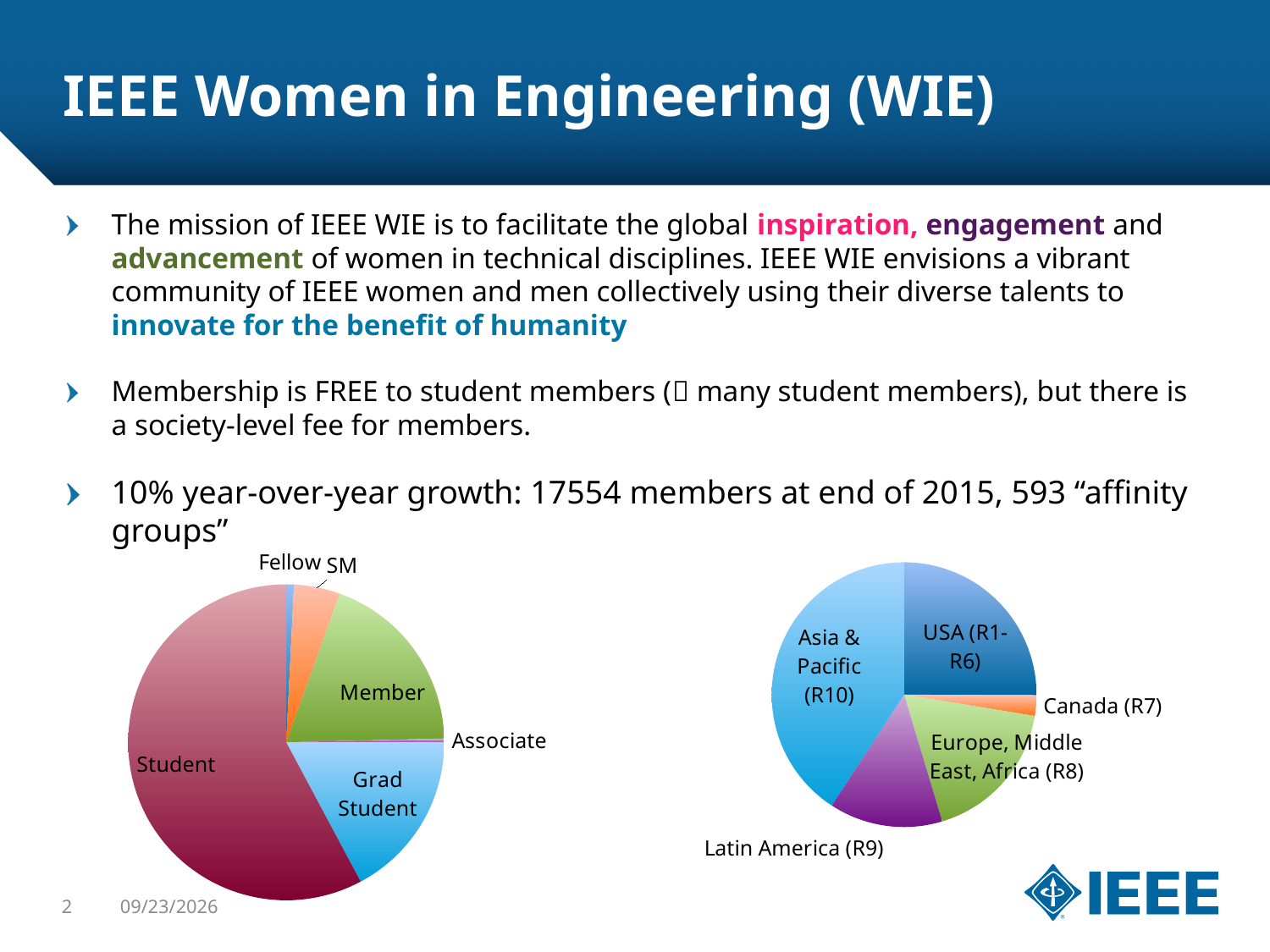
What kind of chart is the left chart on the slide? pie chart In the left pie chart, what colour is the Student slice? dark red In the right pie chart, which slice is larger, USA (R1-R6) or Latin America (R9)? USA (R1-R6) In the right pie chart, which slice is larger, USA (R1-R6) or Canada (R7)? USA (R1-R6) In the left pie chart, which membership grade has the largest slice? Student What kind of chart is the right chart on the slide? pie chart In the right pie chart, which region has the smallest slice? Canada (R7) In the left pie chart, how many slices (membership grades) are shown? 6 In the right pie chart, which region has the largest slice? Asia & Pacific (R10) In the left pie chart, which slice is larger, Student or Member? Student In the right pie chart, how many regions are shown? 5